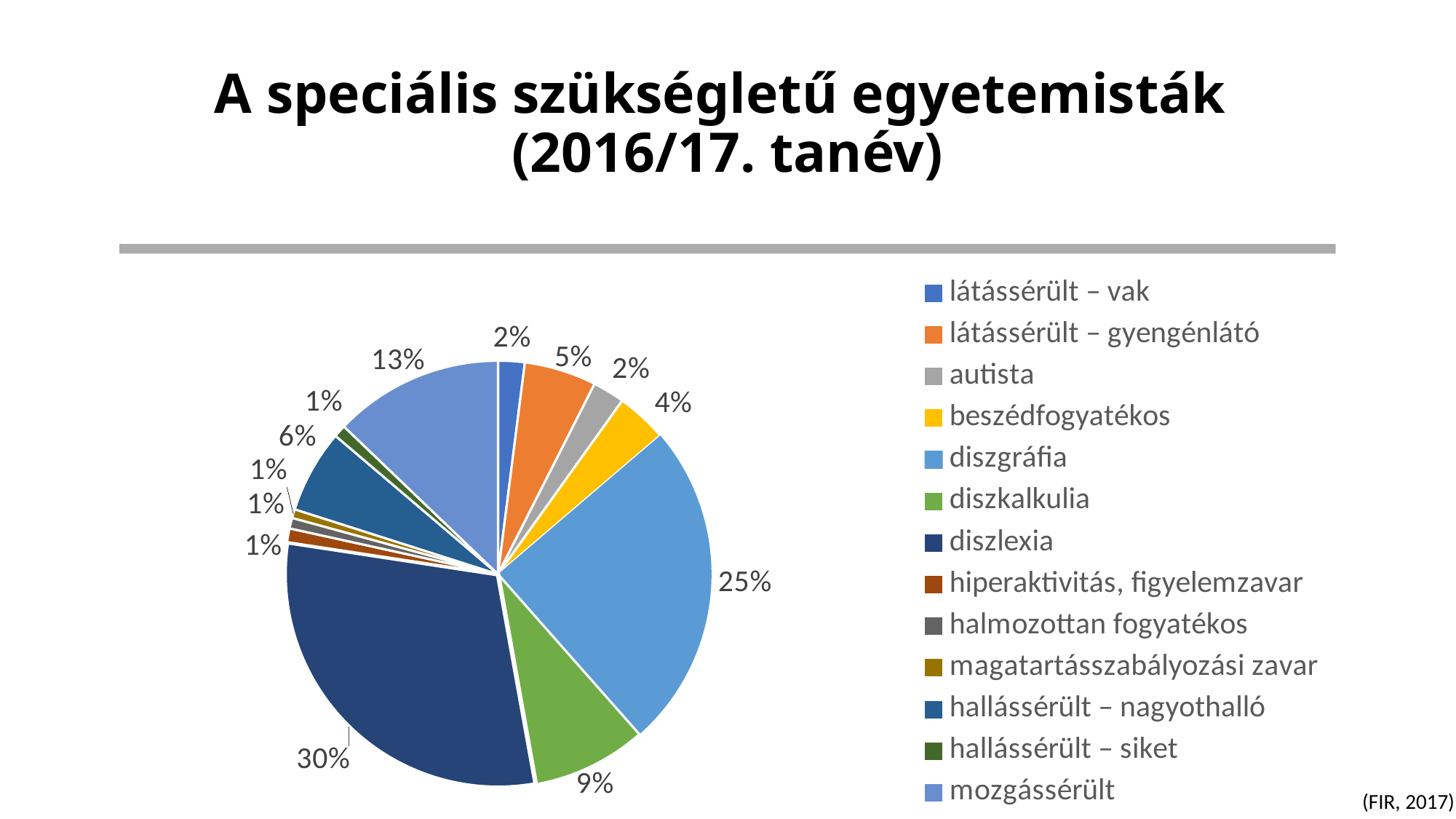
What is the value shown for látássérült – gyengénlátó? 5% What is the difference between the diszlexia and diszgráfia shares? 5% Which is larger, the share for diszkalkulia or the share for mozgássérült? mozgássérült How many categories does the legend list? 13 What share of the pie does diszlexia represent? 30% What is the value shown for mozgássérült? 13% What is the value shown for hallássérült – nagyothalló? 6% What share of the pie does diszgráfia represent? 25% What is the title of the slide? A speciális szükségletű egyetemisták (2016/17. tanév) Which category has the largest slice of the pie? diszlexia What is the difference between the mozgássérült and diszkalkulia shares? 4% What kind of chart is shown on the slide? pie chart